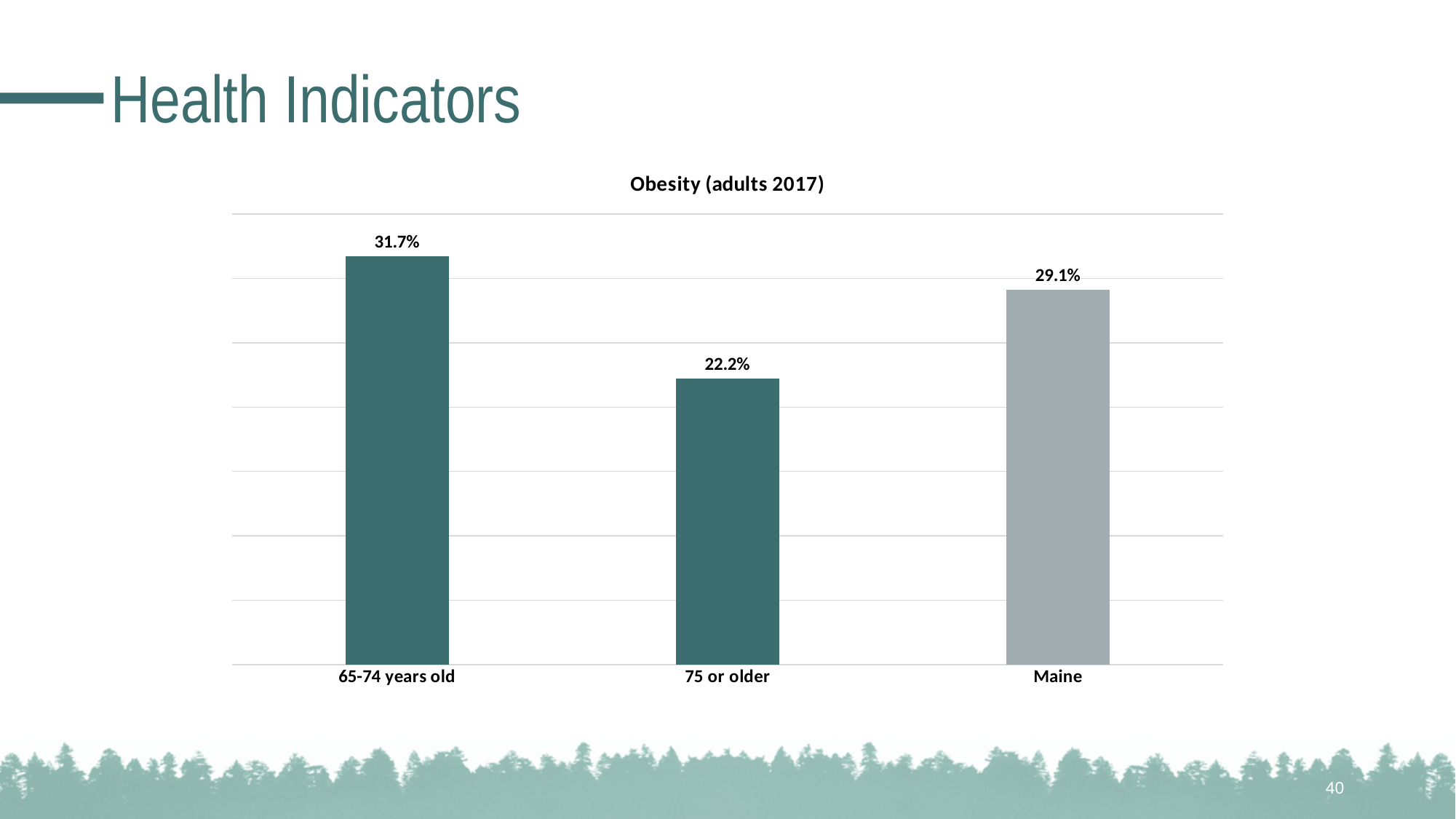
What is the obesity rate shown for Maine? 29.1% What kind of chart is shown on the slide? Bar chart Which is larger, the obesity rate for Maine or for 75 or older? Maine What is the difference between the obesity rate for 65-74 years old and for 75 or older? 9.5% What is the difference between the obesity rate for 65-74 years old and for Maine? 2.6% Which category has the lowest obesity rate? 75 or older Which bar is shown in a different (grey) colour from the others? Maine What is the obesity rate for adults aged 65-74 years old? 31.7% What is the title of the chart? Obesity (adults 2017) What is the obesity rate for adults 75 or older? 22.2% How many categories are shown in the chart? 3 Which category has the highest obesity rate? 65-74 years old